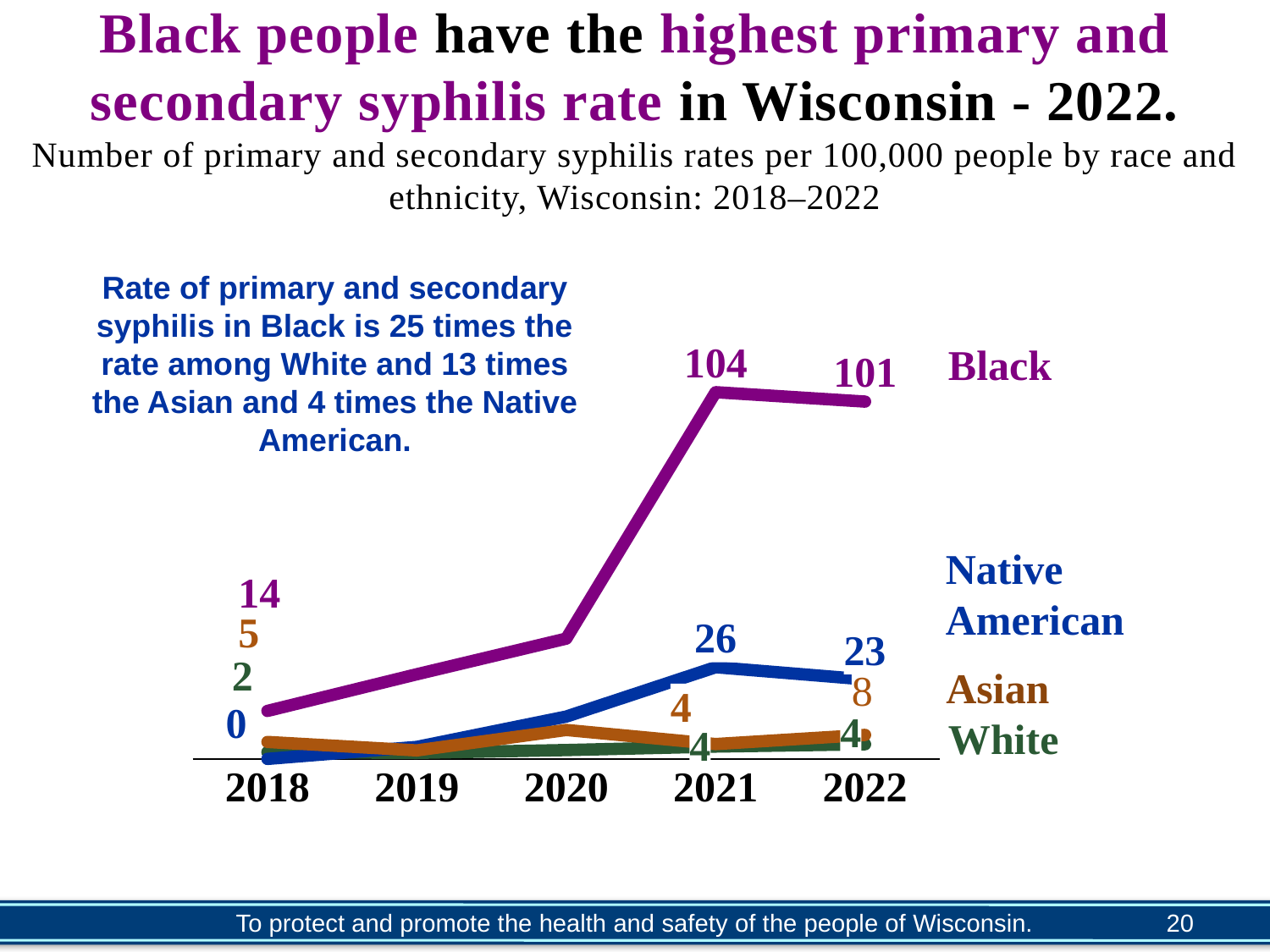
Was the Native American rate higher in 2021 or in 2022? 2021 What was the rate for Native American people in 2021? 26 By how much did the rate for Black people change from 2021 to 2022? 3 Did the rate for Black people rise or fall between 2018 and 2021? rise What was the rate for Black people in 2018? 14 What kind of chart is shown on the slide? line chart What was the primary and secondary syphilis rate for Black people in 2022? 101 How many years are shown on the x axis of the chart? 5 What was the primary and secondary syphilis rate for Black people in 2021? 104 What was the rate for Asian people in 2022? 8 How many race/ethnicity groups are plotted as lines in the chart? 4 Which group had the highest rate in 2022? Black